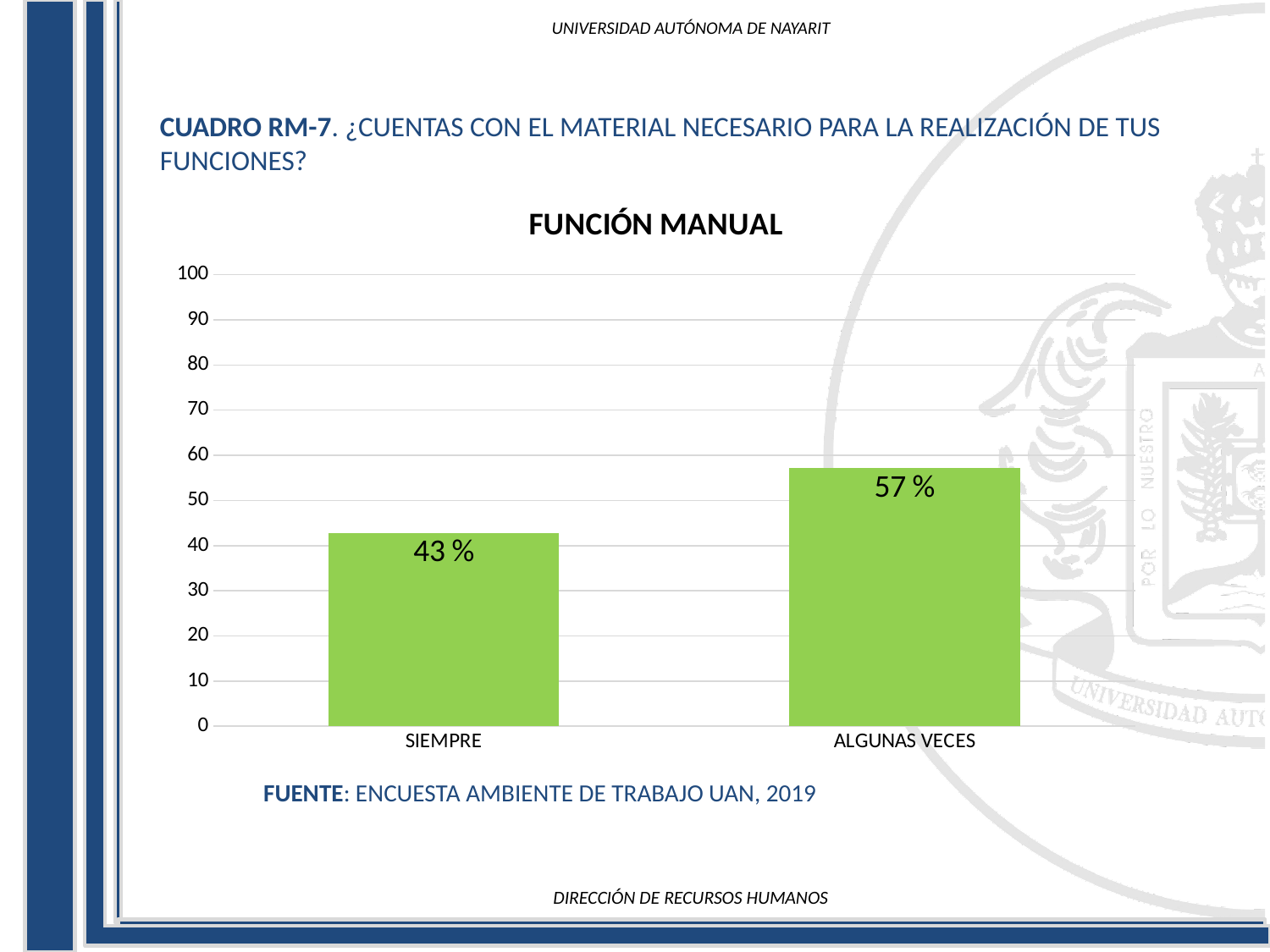
Is the value for SIEMPRE greater or less than 50? less Which category has the lowest value? SIEMPRE Which is larger, the value for SIEMPRE or the value for ALGUNAS VECES? ALGUNAS VECES What is the value for ALGUNAS VECES? 57 % Which category has the highest value? ALGUNAS VECES How many categories are shown on the x axis? 2 What is the value for SIEMPRE? 43 % What kind of chart is shown on the slide? bar chart What is the difference between the values for ALGUNAS VECES and SIEMPRE? 14 % Is the value for ALGUNAS VECES greater or less than 50? greater What is the title of the chart? FUNCIÓN MANUAL What is the highest value shown on the y axis? 100